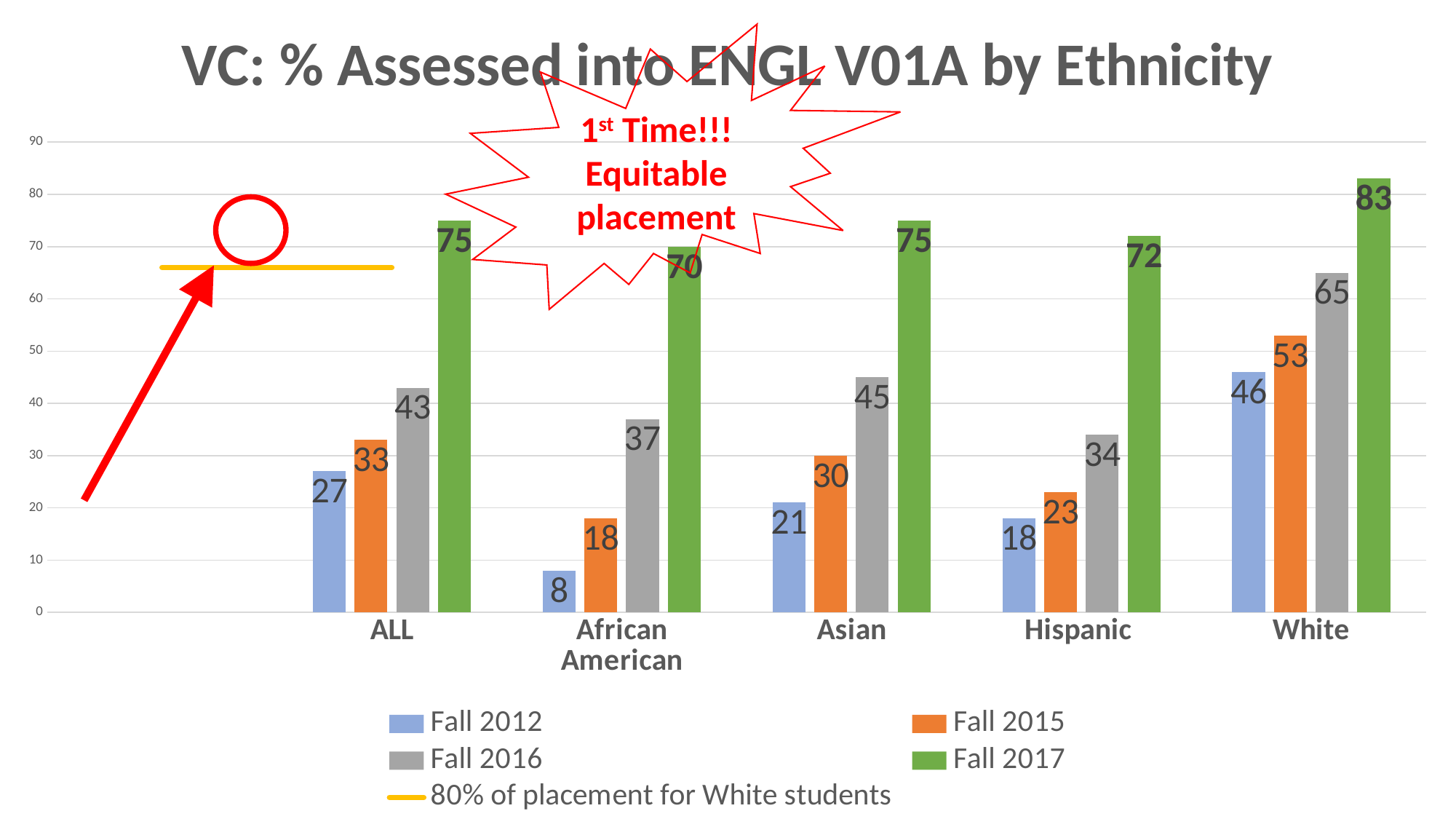
What is the Fall 2012 value for Hispanic students? 18 What is the difference between the Fall 2017 and Fall 2012 values for White students? 37 How many ethnicity categories are shown on the x axis? 5 Which is larger for Hispanic students: the Fall 2015 value or the Fall 2016 value? Fall 2016 Which ethnicity category has the lowest Fall 2012 value? African American Which ethnicity category has the highest Fall 2017 value? White What is the Fall 2017 value for African American students? 70 For the ALL category, do the values rise or fall from Fall 2012 to Fall 2017? Rise How many series does the legend list? 5 What kind of chart is shown on the slide? Bar chart What is the Fall 2016 value for Asian students? 45 What does the yellow line in the legend represent? 80% of placement for White students